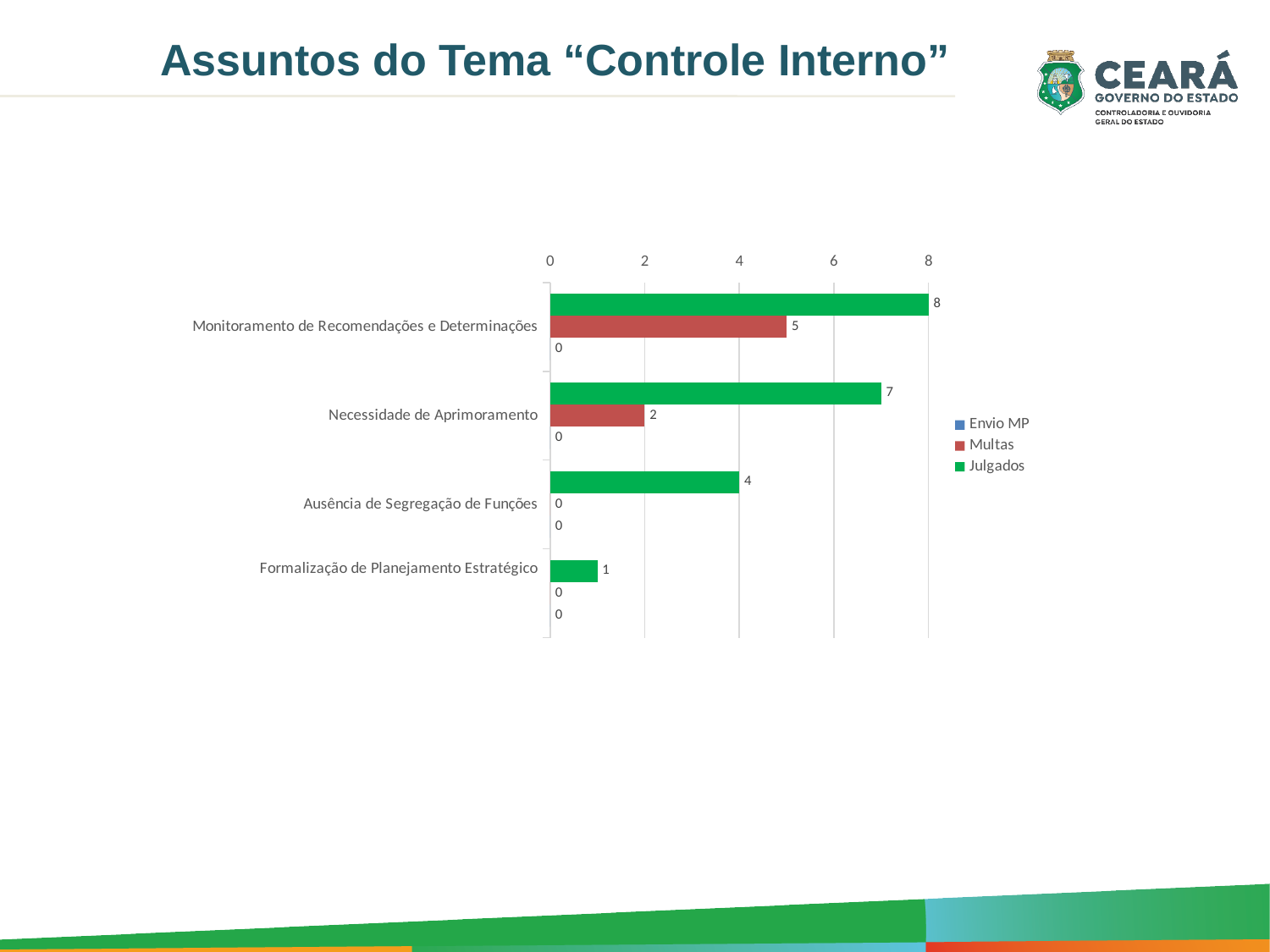
What kind of chart is shown on the slide? Bar chart How many series does the legend list? 3 What is the difference between the Julgados values for Monitoramento de Recomendações e Determinações and Necessidade de Aprimoramento? 1 What is the Julgados value for Ausência de Segregação de Funções? 4 What is the Julgados value for Monitoramento de Recomendações e Determinações? 8 What is the Multas value for Monitoramento de Recomendações e Determinações? 5 Which category has the lowest Julgados value? Formalização de Planejamento Estratégico Which series is shown in green in the legend? Julgados Which is larger: the Multas value for Monitoramento de Recomendações e Determinações or the Multas value for Necessidade de Aprimoramento? Monitoramento de Recomendações e Determinações What is the Multas value for Necessidade de Aprimoramento? 2 How many categories are shown on the chart? 4 Which category has the highest Julgados value? Monitoramento de Recomendações e Determinações